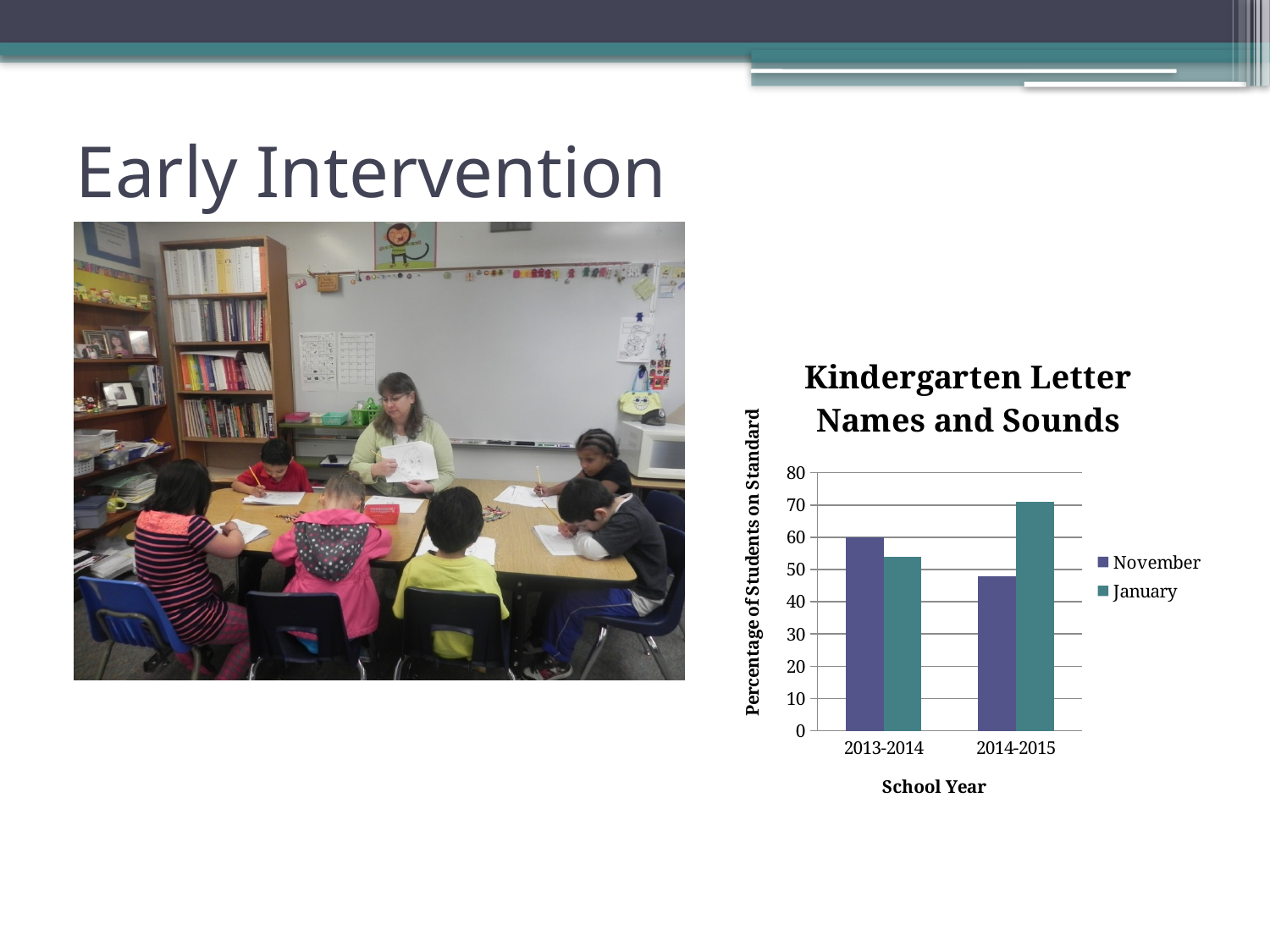
Which school year has the higher January value? 2014-2015 What is the title of the chart? Kindergarten Letter Names and Sounds Which school year has the higher November value? 2013-2014 How many school years are shown on the x axis of the chart? 2 Which bar is the tallest in the chart? January 2014-2015 How many series does the chart's legend list? 2 What kind of chart is shown on the slide? bar chart Is the November value for 2014-2015 greater or less than 50? less What is the November value for 2013-2014? 60 What is the label of the y axis? Percentage of Students on Standard Is the January value for 2013-2014 greater or less than 50? greater